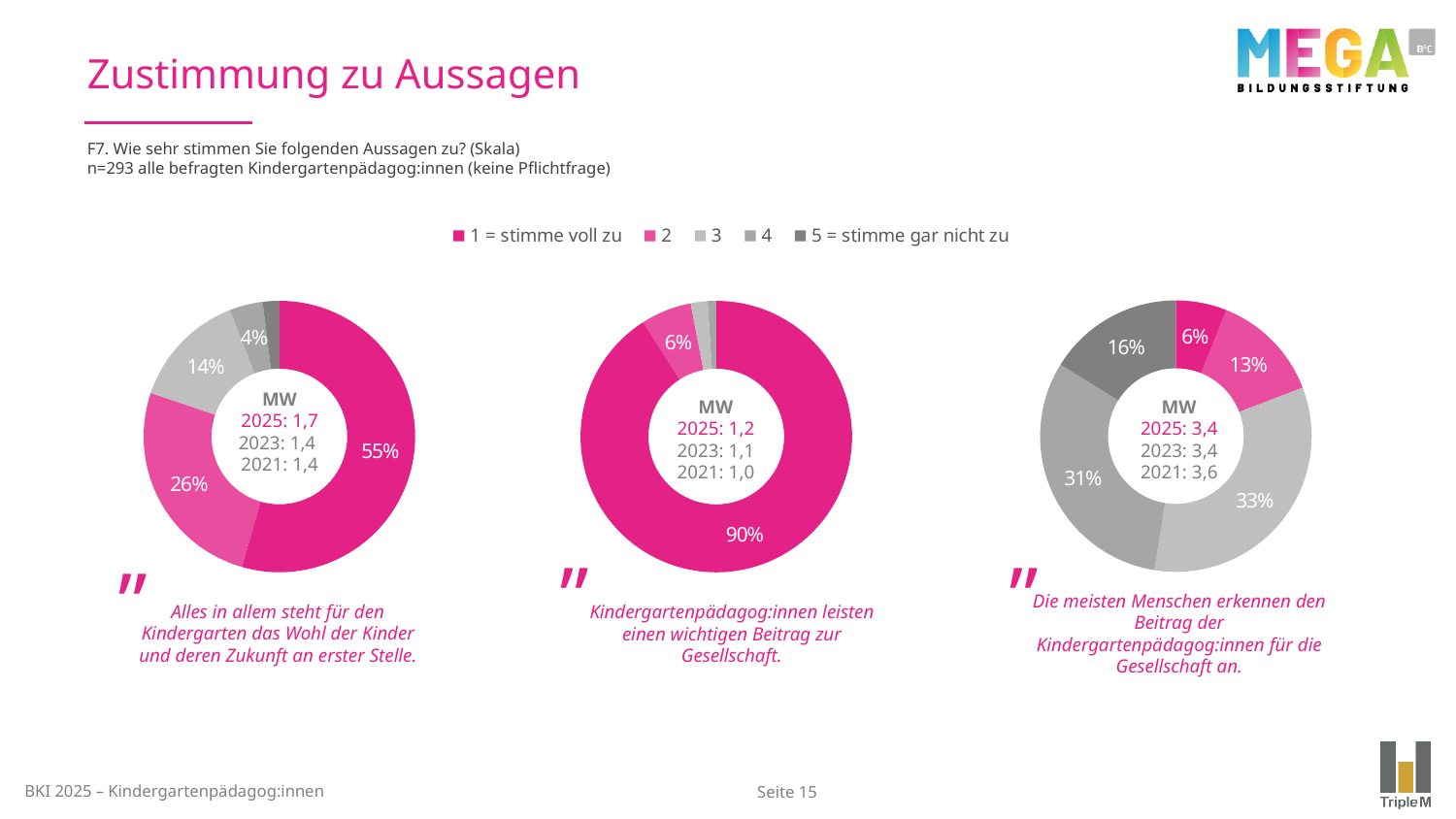
In the left chart, what is the difference between the share answering "1 = stimme voll zu" and the share answering "2"? 29 percentage points In the middle chart ("Kindergartenpädagog:innen leisten einen wichtigen Beitrag zur Gesellschaft"), what share of respondents answered "1 = stimme voll zu"? 90% In the left chart ("Alles in allem steht für den Kindergarten das Wohl der Kinder..."), what share of respondents answered "1 = stimme voll zu"? 55% In the right chart, what share of respondents answered "5 = stimme gar nicht zu"? 16% What type of chart is used on this slide? Donut (pie) chart In the right chart ("Die meisten Menschen erkennen den Beitrag..."), what share of respondents answered "3"? 33% In the left chart, is the share for "2" larger or smaller than the share for "3"? larger What is the mean value (MW) for 2021 shown in the right chart? 3,6 In the right chart, which answer category has the smallest share? 1 = stimme voll zu In the right chart, which answer category has the largest share? 3 How many answer categories does the legend list? 5 What is the mean value (MW) for 2025 shown in the middle chart? 1,2